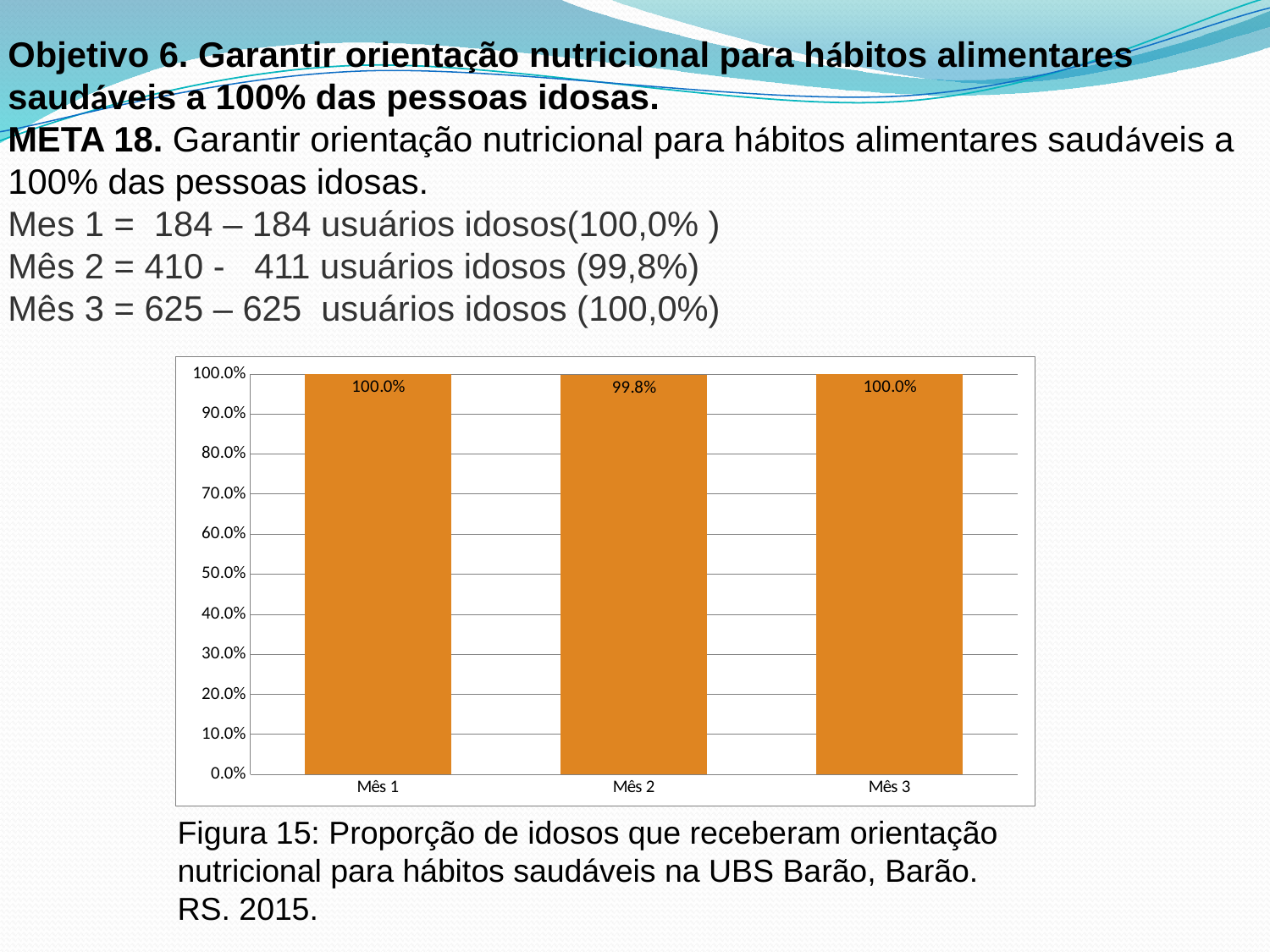
Does the value rise or fall from Mês 1 to Mês 2? fall What colour are the bars? orange Is the value for Mês 2 greater or less than 90.0%? greater What is the figure number given in the caption below the chart? Figura 15 What is the value for Mês 3? 100.0% How many months are shown on the x axis? 3 What is the value for Mês 2? 99.8% What is the value for Mês 1? 100.0% Which month has the lowest value? Mês 2 What kind of chart is shown? bar chart What is the difference between the values for Mês 1 and Mês 2? 0.2% Which is larger, the value for Mês 2 or the value for Mês 3? Mês 3